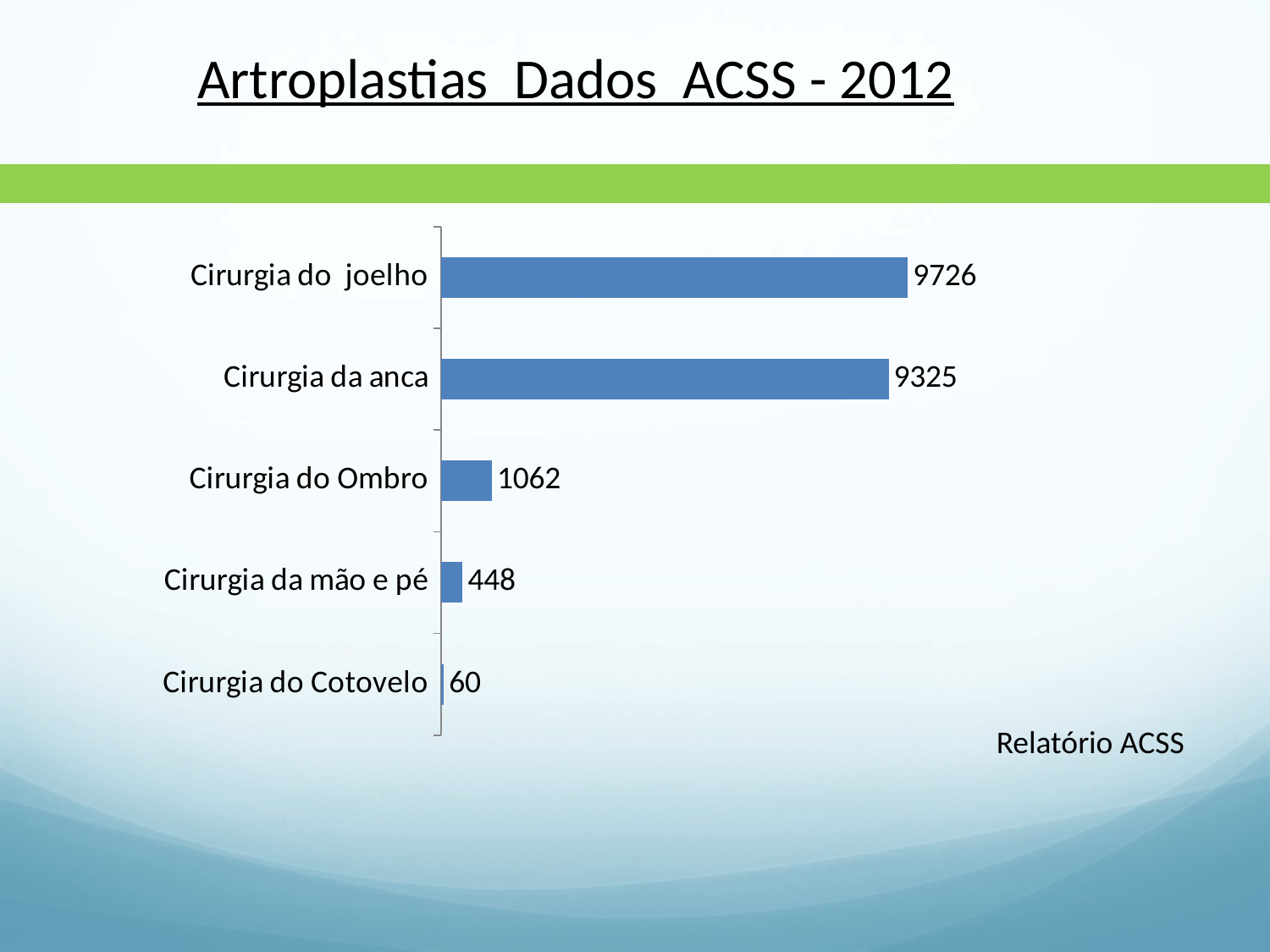
What is the value for Cirurgia da anca? 9325 What is the difference between the values for Cirurgia do joelho and Cirurgia da anca? 401 How many categories are shown in the chart? 5 What is the value for Cirurgia do Cotovelo? 60 What kind of chart is shown on the slide? Bar chart Which category has the highest value? Cirurgia do joelho What is the value for Cirurgia do joelho? 9726 What is the value for Cirurgia do Ombro? 1062 Which category has the lowest value? Cirurgia do Cotovelo Which is larger, the value for Cirurgia do Ombro or the value for Cirurgia da mão e pé? Cirurgia do Ombro What is the value for Cirurgia da mão e pé? 448 What is the difference between the values for Cirurgia do Ombro and Cirurgia da mão e pé? 614